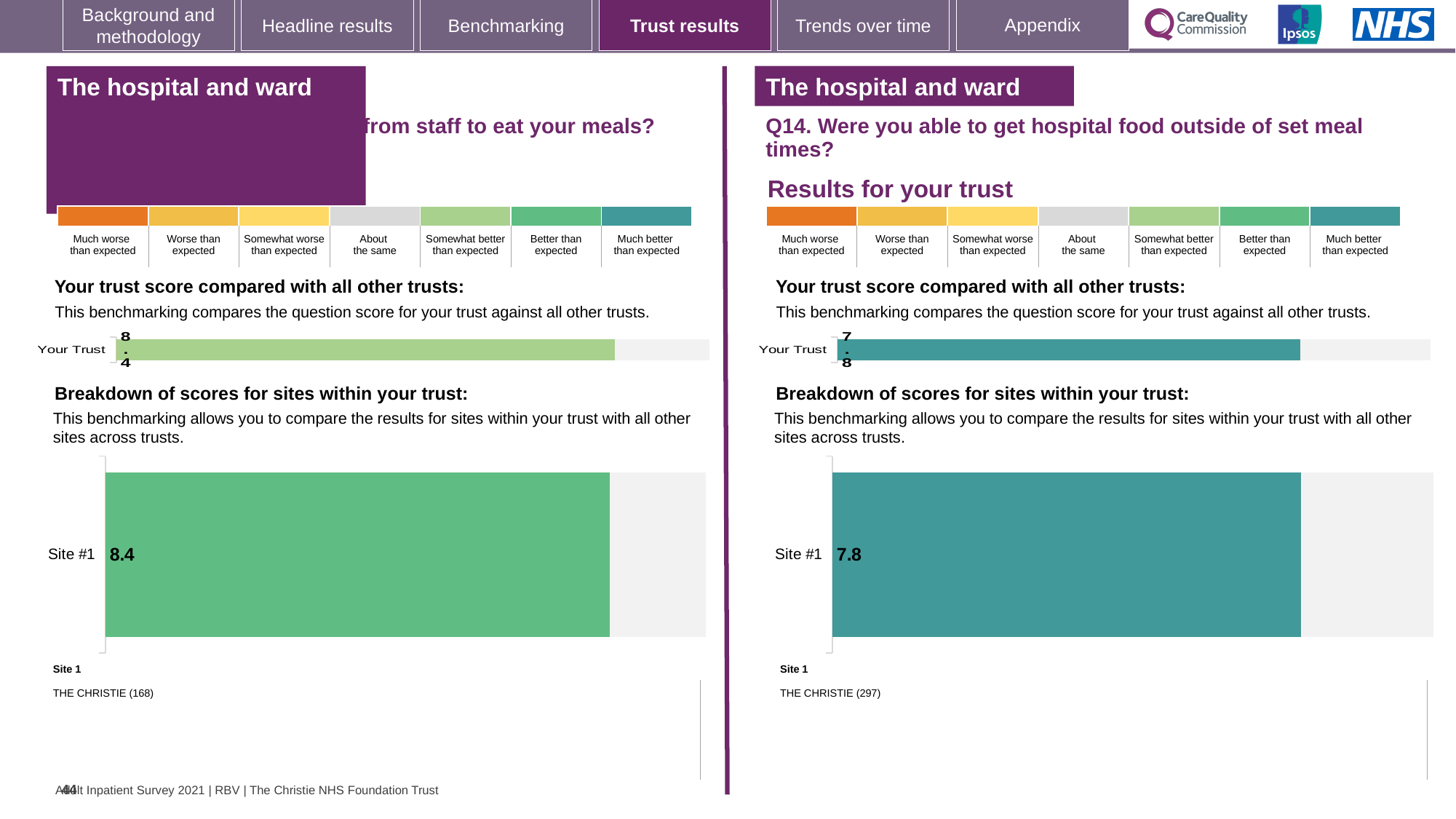
Which benchmark category does the colour of the Q14 Your Trust bar on the right correspond to? Much better than expected How many sites are shown in the site breakdown chart on the left half of the slide? 1 On the right half of the slide (Q14), what is the score shown for Your Trust? 7.8 In the Q14 site breakdown chart on the right, what is the score for Site #1? 7.8 What type of chart is used to show the Site #1 score in the Q14 breakdown on the right? Bar chart What is the difference between the Site #1 score on the left chart and the Site #1 score on the right (Q14) chart? 0.6 On the left half of the slide, what is the score shown for Your Trust? 8.4 Is the Site #1 score in the left breakdown chart the same as the Your Trust score on the left? Yes Which is larger: the Your Trust score on the left half of the slide or the Your Trust score for Q14 on the right? The left half (8.4) What is the name of Site 1 listed under the Q14 breakdown chart on the right? THE CHRISTIE (297) In the left site breakdown chart, what is the score for Site #1? 8.4 How many sites are shown in the Q14 site breakdown chart on the right? 1